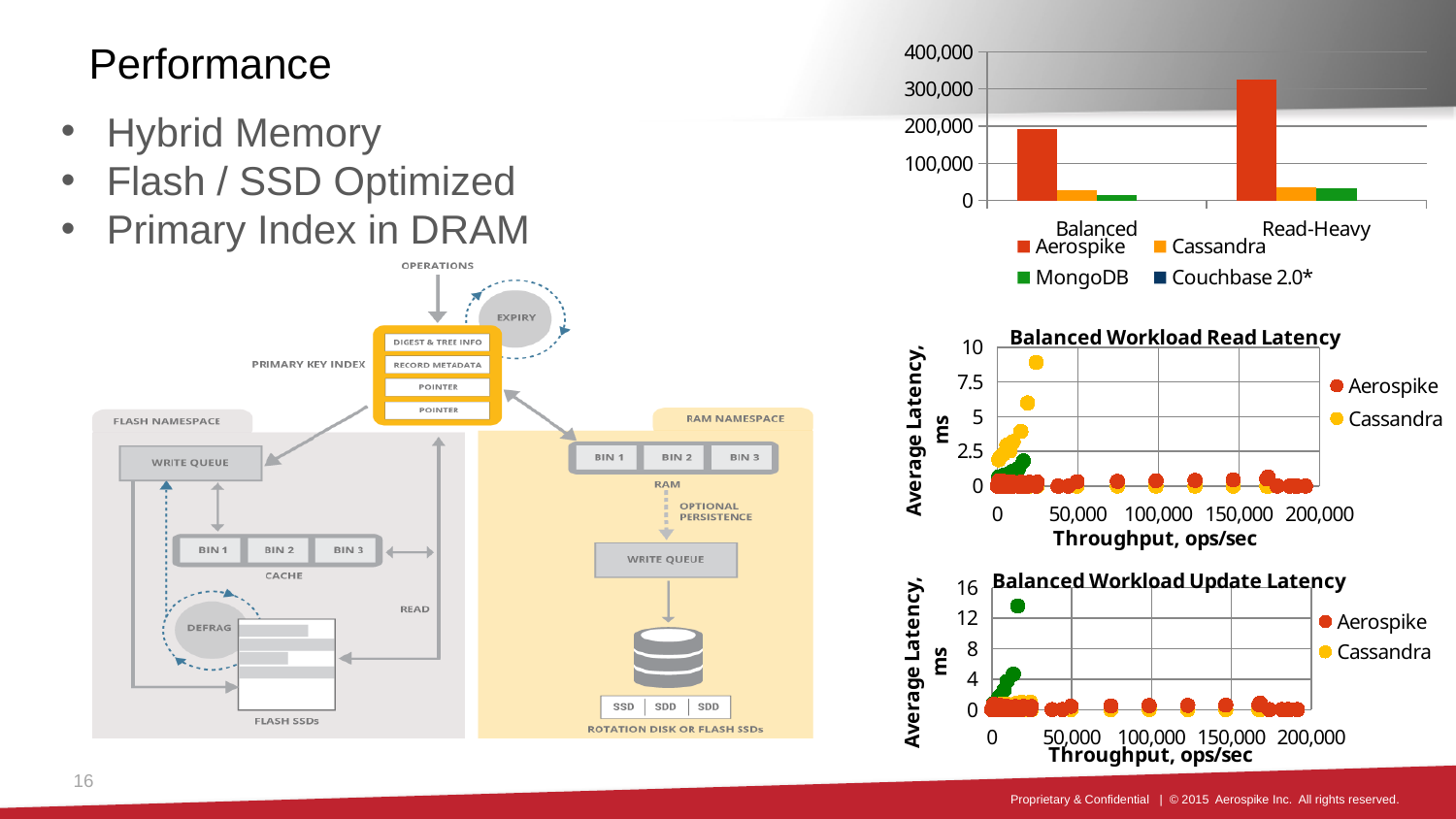
How many series does the legend of the 'Balanced Workload Read Latency' chart list? 2 In the top-right bar chart, which series has the highest value for Read-Heavy? Aerospike In the top-right bar chart, is the Aerospike value for Read-Heavy greater or less than 300,000? greater How many categories are shown on the x axis of the top-right bar chart? 2 In the top-right bar chart, which series has the lowest value for Balanced among the bars shown? MongoDB What kind of chart is the chart at the top right of the slide? bar chart What kind of chart is the 'Balanced Workload Update Latency' chart? scatter chart What is the x-axis label of the 'Balanced Workload Update Latency' chart? Throughput, ops/sec How many series does the legend of the top-right bar chart list? 4 In the top-right bar chart, is the Aerospike value for Balanced greater or less than 100,000? greater In the top-right bar chart, is the Aerospike value larger for Balanced or for Read-Heavy? Read-Heavy In the top-right bar chart, is the Cassandra value for Balanced greater or less than 100,000? less